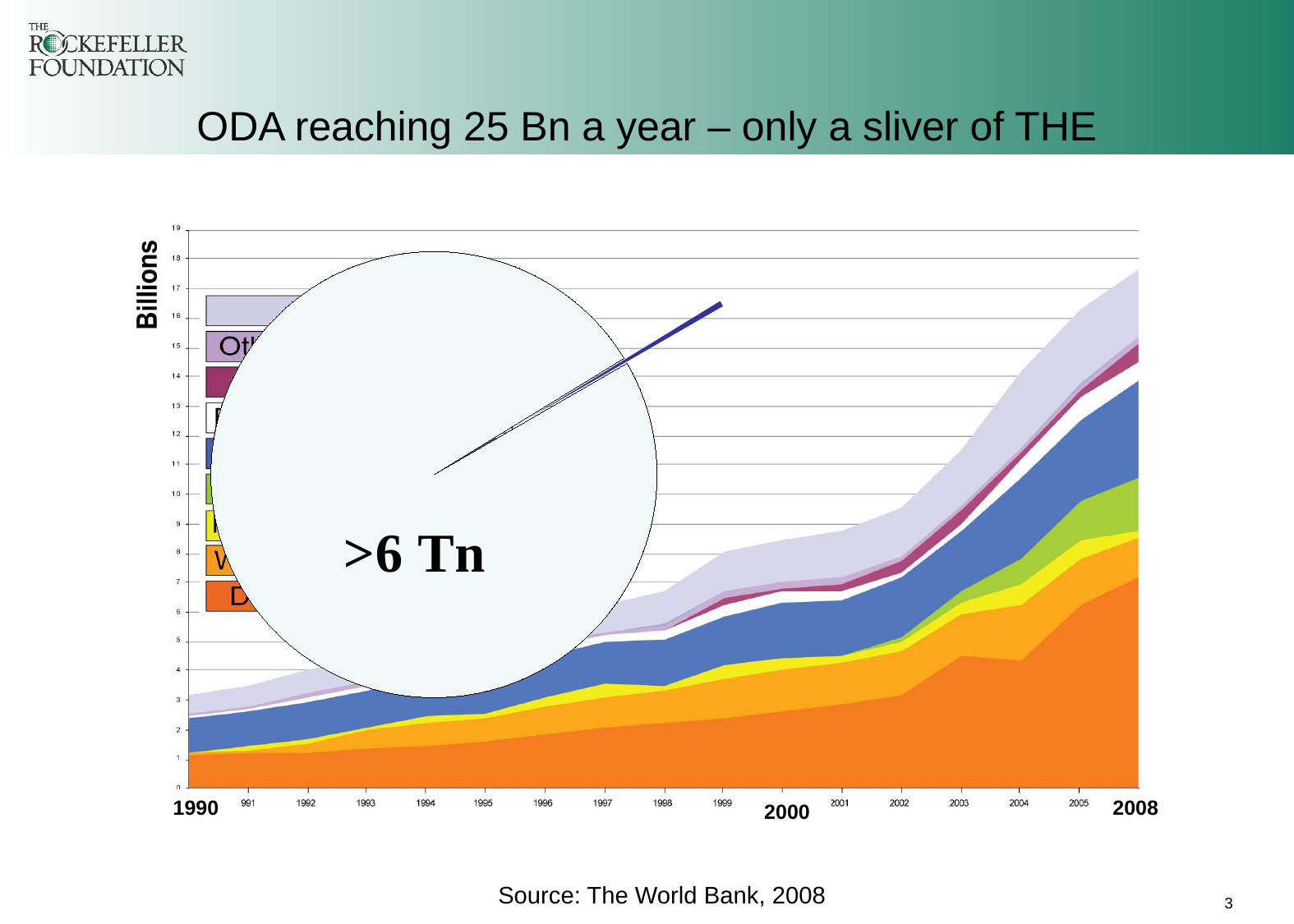
Is the total of the stacked areas in 2002 greater or less than 10 billion? less What kind of chart is the large chart showing values in billions from 1990 to 2008? stacked area chart Is the total of the stacked areas in 2008 greater or less than 15 billion? greater How many years are shown along the x axis of the area chart, from 1990 to 2008 inclusive? 19 What is the highest tick value shown on the vertical axis of the area chart? 19 Is the total of the stacked areas in 2005 greater or less than 14 billion? greater Which year has the highest total of the stacked areas, 1990 or 2008? 2008 Does the total height of the stacked areas rise or fall from 1990 to 2008? rise What value is printed inside the circular pie chart overlaid on the area chart? >6 Tn What is the label on the vertical axis of the area chart? Billions